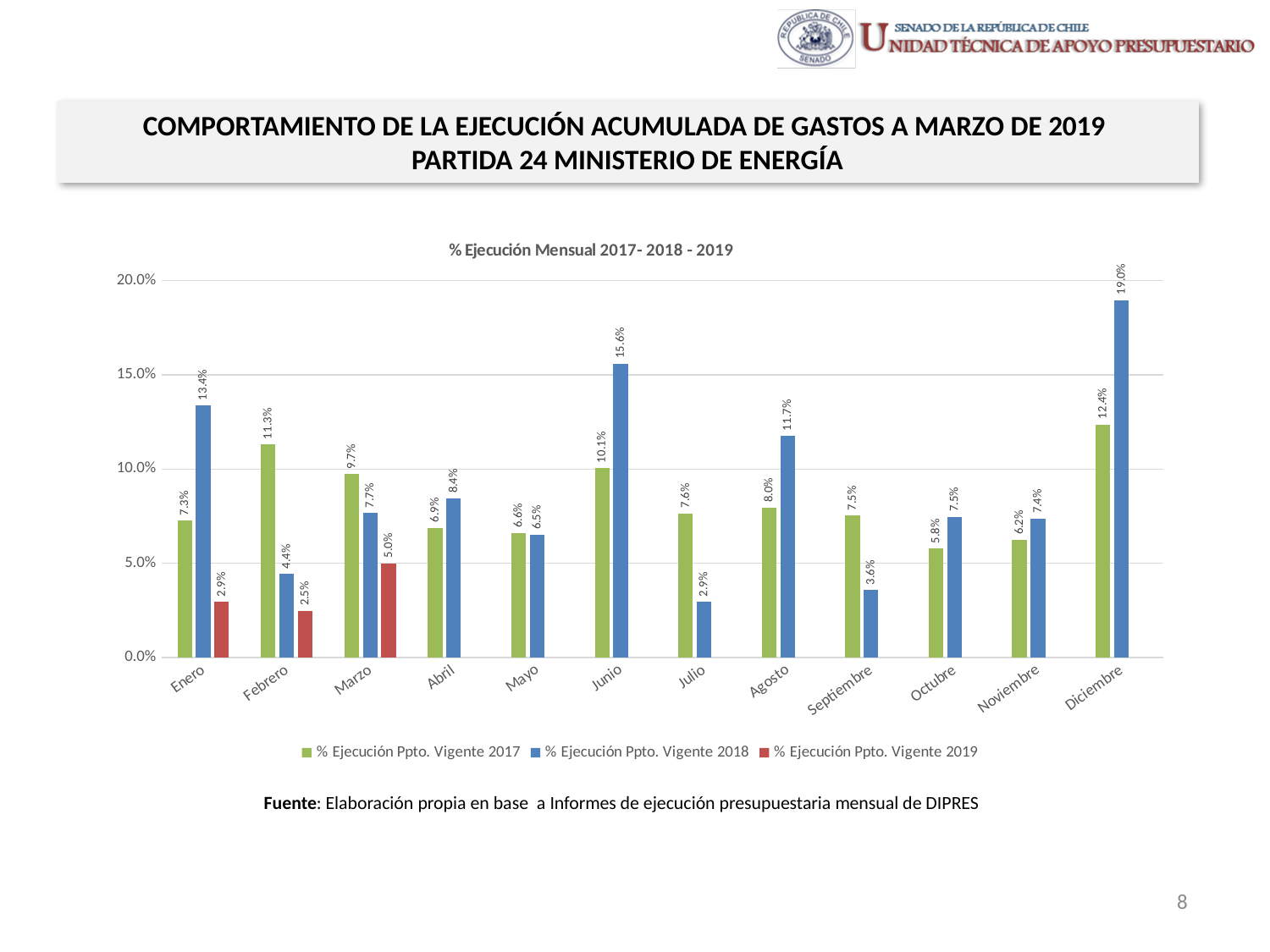
What is the difference between the 2018 and 2017 values in Enero? 6.1% What is the title of the chart? % Ejecución Mensual 2017- 2018 - 2019 Which is larger in Marzo: the 2017 value or the 2018 value? 2017 (9.7%) Which month has the lowest value for % Ejecución Ppto. Vigente 2017? Octubre What is the value for % Ejecución Ppto. Vigente 2018 in Junio? 15.6% What is the value for % Ejecución Ppto. Vigente 2019 in Marzo? 5.0% Is the value for % Ejecución Ppto. Vigente 2018 in Agosto greater or less than 10.0%? greater How many months are shown on the x axis? 12 Which month has the highest value for % Ejecución Ppto. Vigente 2018? Diciembre What is the value for % Ejecución Ppto. Vigente 2017 in Febrero? 11.3% What kind of chart is shown? Bar chart How many series does the legend list? 3